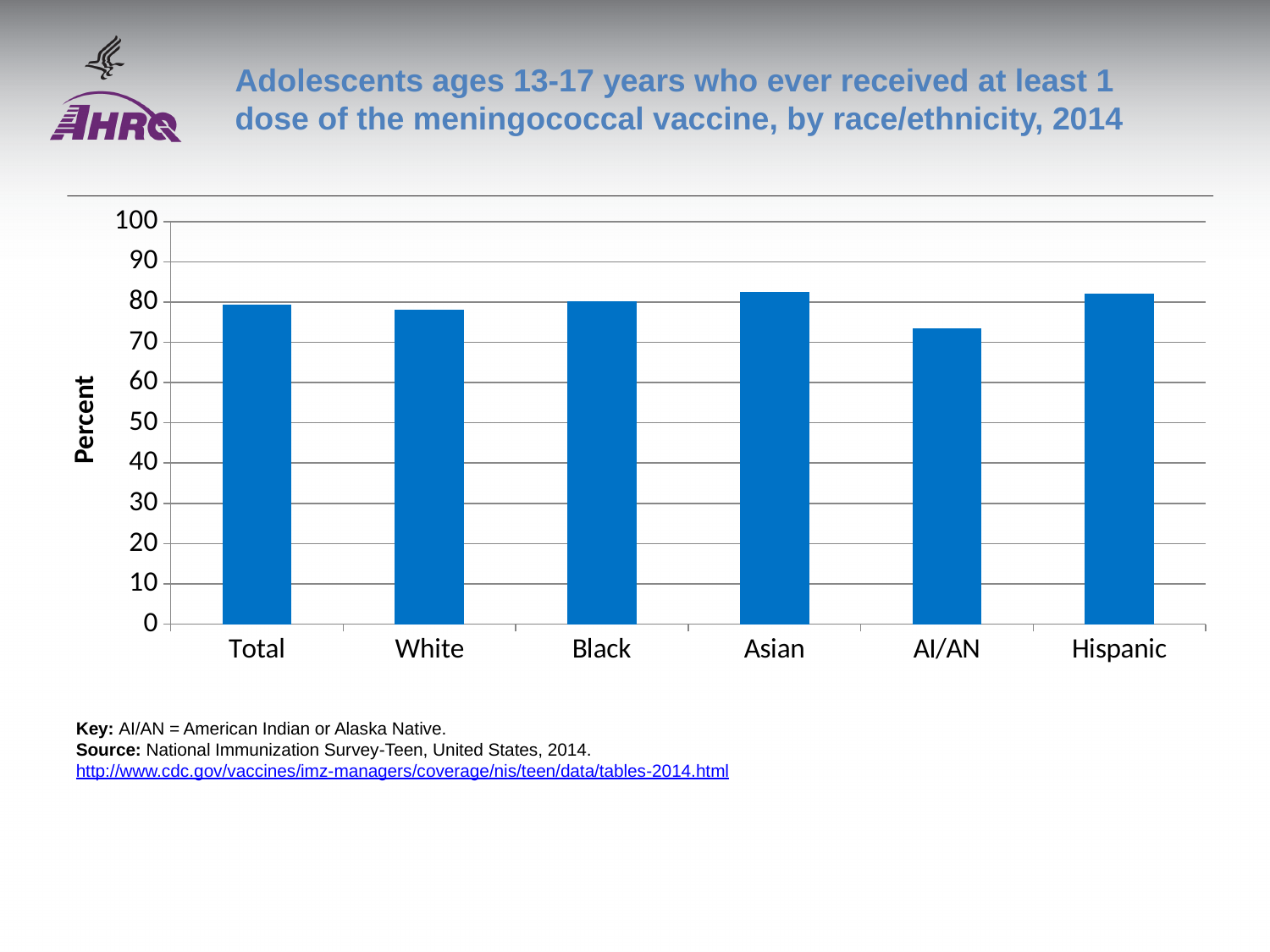
Which is larger, the value for Asian or the value for AI/AN? Asian What is the label on the y axis? Percent Which is larger, the value for White or the value for Hispanic? Hispanic Is the value for Asian greater or less than 80? greater According to the key, what does AI/AN stand for? American Indian or Alaska Native Is the value for AI/AN greater or less than 70? greater Which category has the lowest percentage? AI/AN Is the value for Hispanic greater or less than 80? greater How many race/ethnicity categories are shown on the x axis? 6 What kind of chart is shown on the slide? bar chart